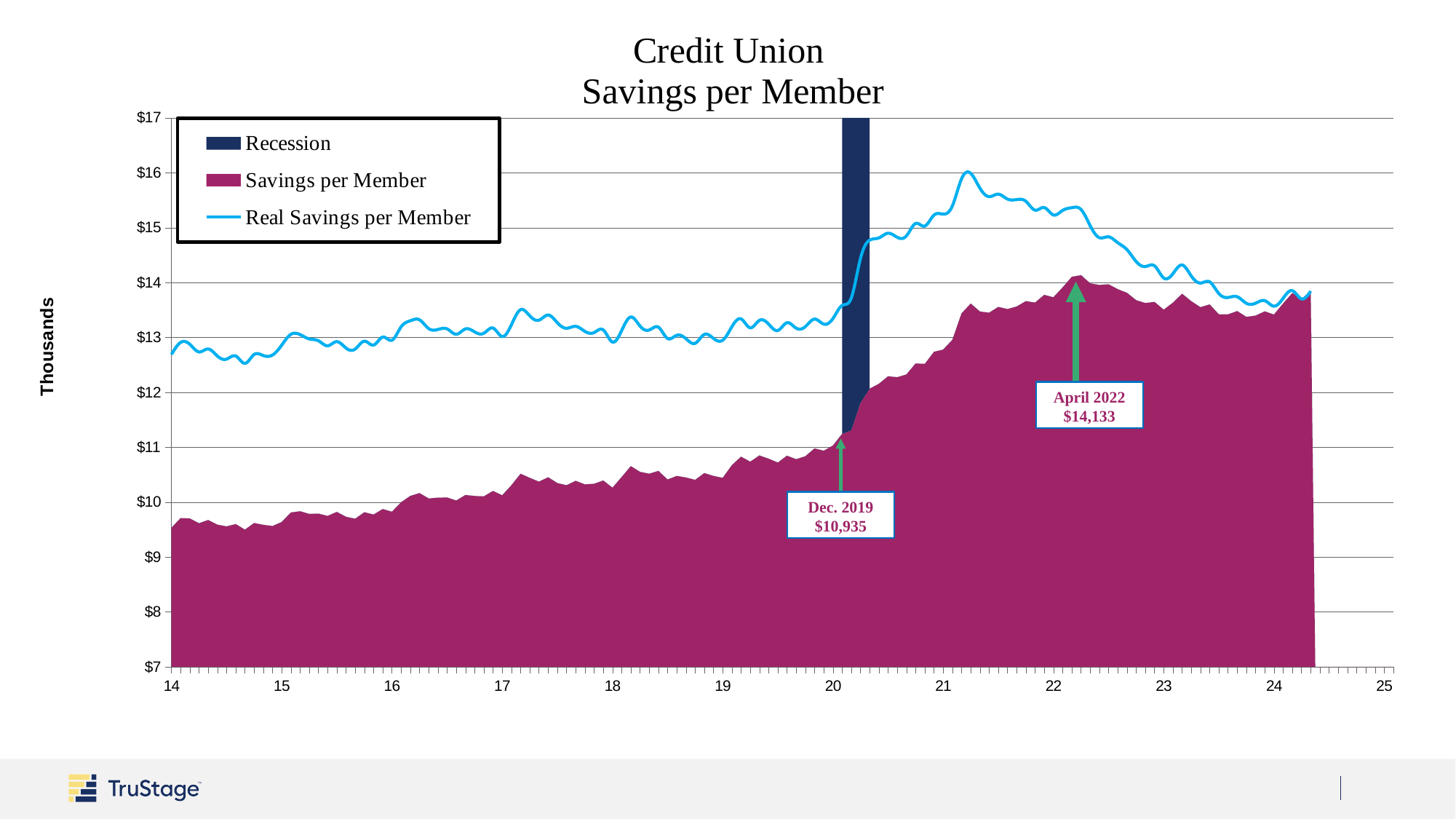
By how much did Savings per Member increase between the Dec. 2019 label and the April 2022 label? $3,198 Does Savings per Member generally rise or fall from 2014 to 2024? Rise What unit label is shown on the vertical axis? Thousands What kind of chart is shown on the slide? Combination area and line chart Is the Savings per Member value at the start of 2018 greater or less than $10? greater What is the value of Savings per Member in April 2022, as labeled on the chart? $14,133 Which of the two labeled values, Dec. 2019 or April 2022, is larger? April 2022 How many entries does the legend list? 3 Is the Savings per Member value at the start of 2014 greater or less than $10? less Is the Real Savings per Member value at the start of 2014 greater or less than $13? less Does Real Savings per Member rise or fall from its 2021 peak to 2024? Fall What is the value of Savings per Member in Dec. 2019, as labeled on the chart? $10,935